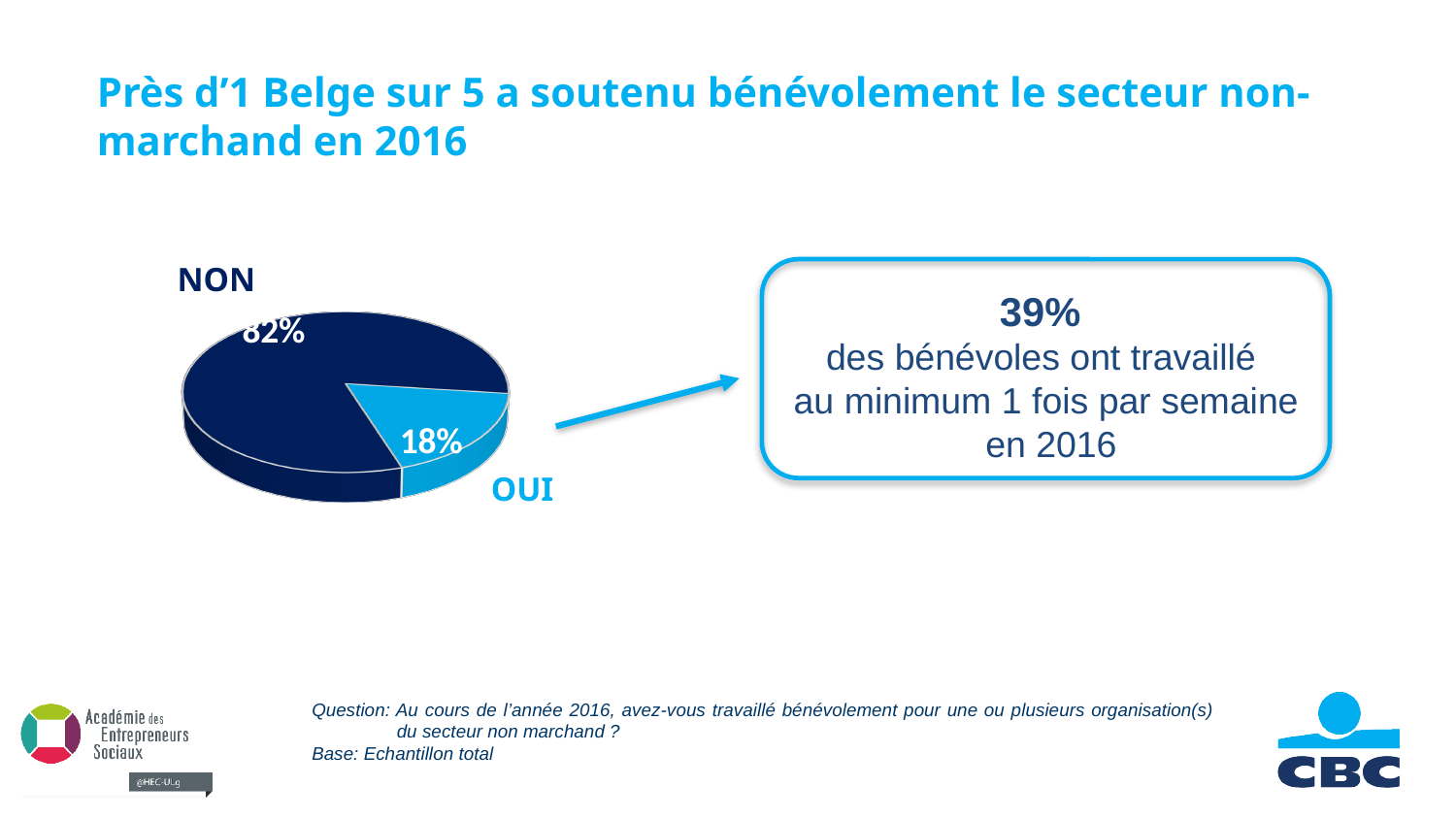
What kind of chart is shown on the slide? pie chart Which slice of the pie chart is the smallest? OUI What share of the pie does the OUI slice represent? 18% What percentage is shown in the callout box to the right of the pie chart? 39% What is the value for NON in the pie chart? 82% Which is larger in the pie chart, OUI or NON? NON What colour is the OUI slice in the pie chart? light blue How many slices does the pie chart have? 2 What is the value for OUI in the pie chart? 18% What is the difference between the NON and OUI values in the pie chart? 64% Which slice of the pie chart is the largest? NON